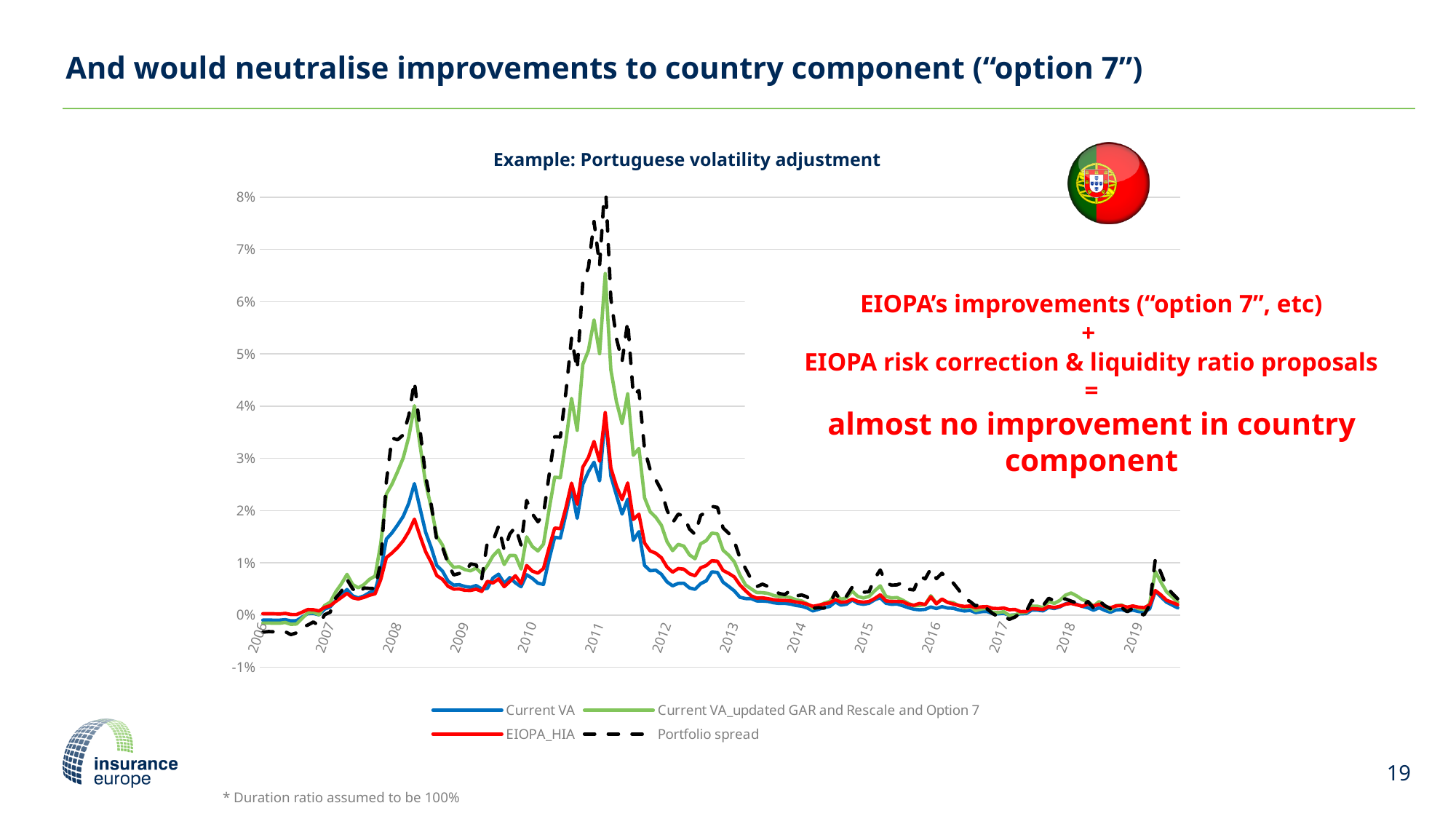
What kind of chart is shown on the slide? Line chart Which series reaches the highest peak on the chart? Portfolio spread How many year labels are shown on the x axis? 14 Which series has the lowest peak around 2011? Current VA Which series is drawn as a dashed black line? Portfolio spread Is the peak value of Current VA_updated GAR and Rescale and Option 7 around 2011 greater or less than 6%? greater What is the title of the chart? Example: Portuguese volatility adjustment How many series does the chart legend list? 4 Is the peak value of Current VA around 2008 greater or less than 3%? less Around 2011, which series is higher: EIOPA_HIA or Current VA? EIOPA_HIA Is the peak value of Portfolio spread around 2011 greater or less than 7%? greater Do the series values rise or fall between 2011 and 2014? Fall